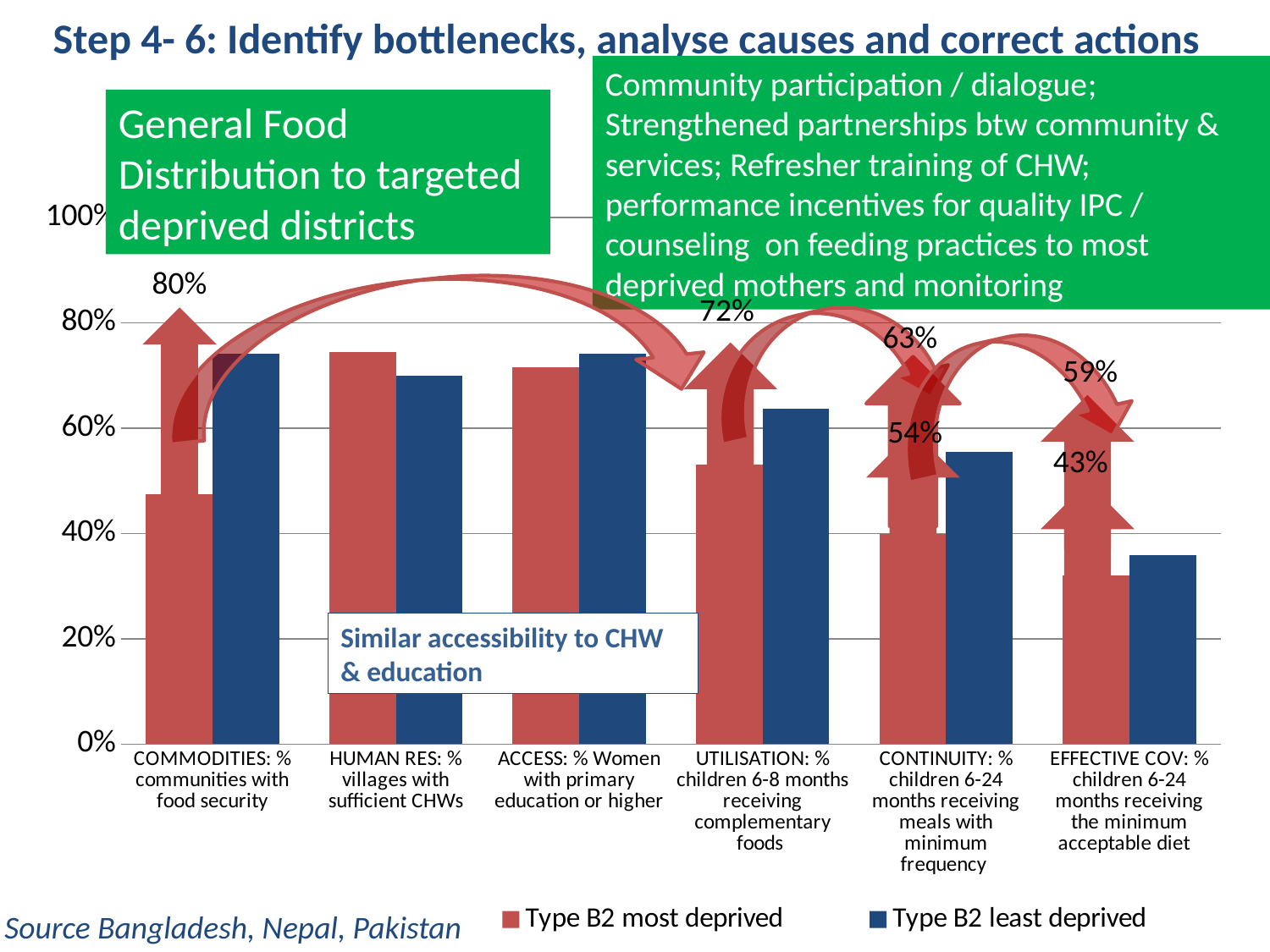
Do the values for Type B2 least deprived generally rise or fall from left to right across the categories? fall Is the value for Type B2 most deprived in the HUMAN RES category greater or less than 60%? greater Is the value for Type B2 least deprived in the EFFECTIVE COV category greater or less than 60%? less For the Type B2 least deprived series, which category has the lowest value? EFFECTIVE COV: % children 6-24 months receiving the minimum acceptable diet Which series is shown in red in the chart? Type B2 most deprived Is the value for Type B2 least deprived in the COMMODITIES category greater or less than 60%? greater What are the two series named in the chart legend? Type B2 most deprived; Type B2 least deprived In the COMMODITIES category, which series has the larger value: Type B2 most deprived or Type B2 least deprived? Type B2 least deprived What kind of chart is shown on the slide? bar chart How many series does the chart legend list? 2 How many categories are shown along the x axis of the chart? 6